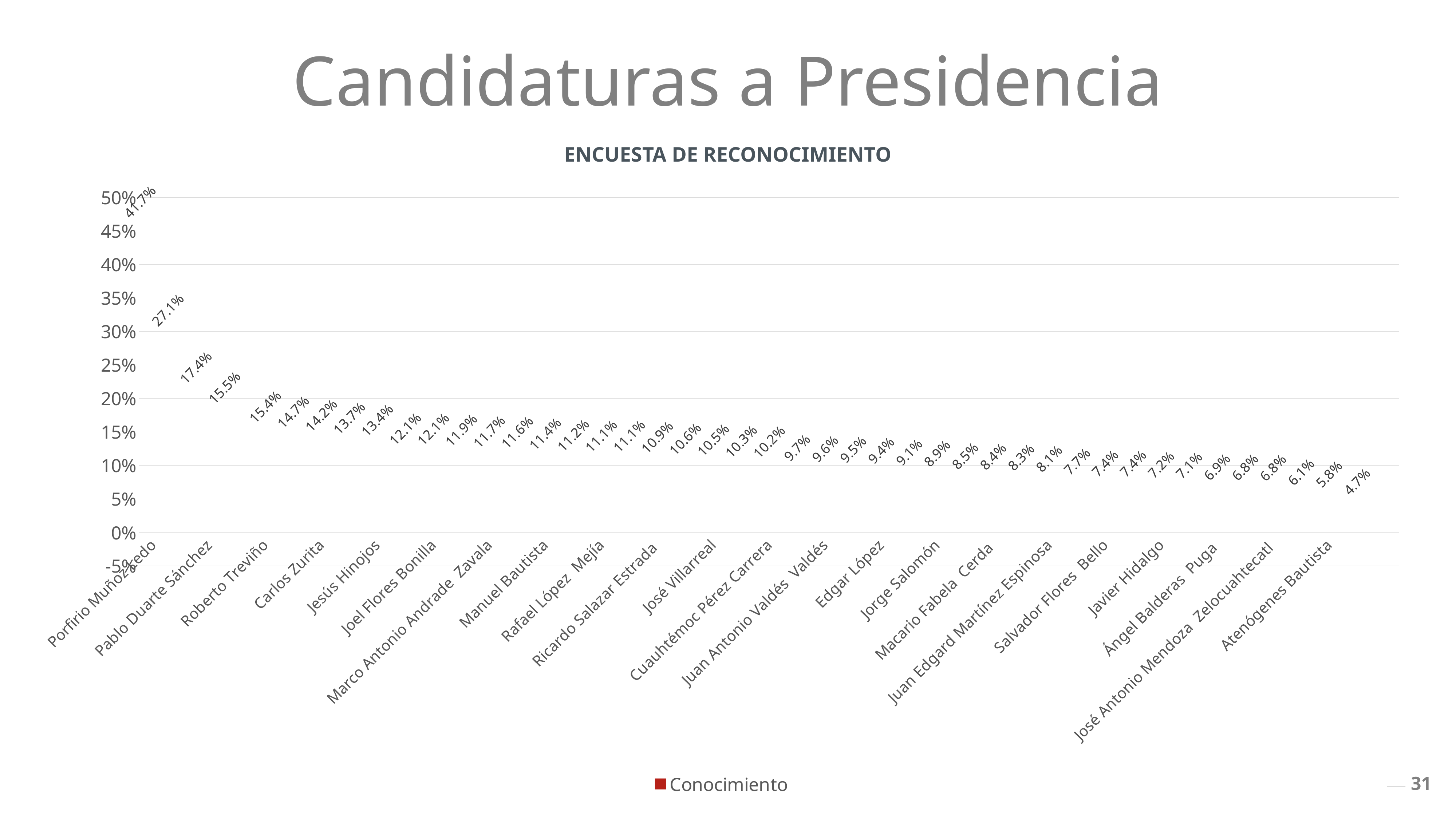
What is the difference between the values for Porfirio Muñoz Ledo and Pablo Duarte Sánchez? 24.3 percentage points Is the value for Porfirio Muñoz Ledo greater or less than 40%? greater Which candidate has the highest value? Porfirio Muñoz Ledo Which is larger, the value for Roberto Treviño or the value for Jesús Hinojos? Roberto Treviño What is the value for Pablo Duarte Sánchez? 17.4% How many series does the legend list? 1 What is the value for Porfirio Muñoz Ledo? 41.7% What is the value for Atenógenes Bautista? 5.8% What is the lowest value shown on the chart? 4.7% How many data points are plotted on the chart? 44 What is the name of the series shown in the legend? Conocimiento Do the values rise or fall from left to right along the x axis? fall